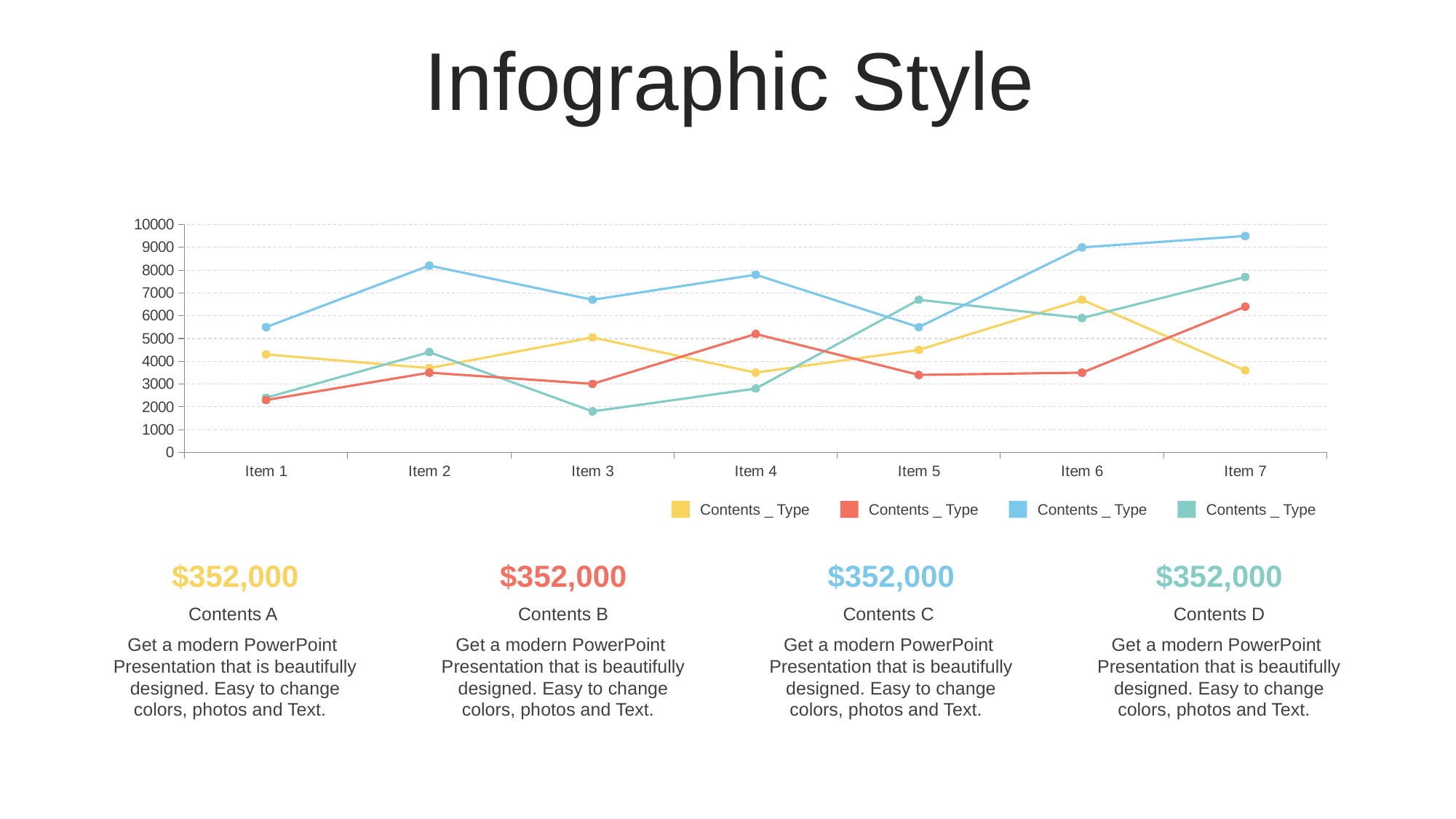
At which item does the green line reach its lowest value? Item 3 How many items (categories) are plotted along the x axis of the chart? 7 Is the value of the yellow line at Item 6 greater or less than 6000? greater How many series does the chart's legend list? 4 Is the value of the red line at Item 7 greater or less than 6000? greater At which item does the blue line reach its highest value? Item 7 Is the value of the green line at Item 3 greater or less than 2000? less Does the blue line rise or fall from Item 5 to Item 7? Rise At which item does the yellow line reach its highest value? Item 6 At Item 2, which line has the larger value, the blue line or the red line? Blue line What kind of chart is shown on the slide? Line chart